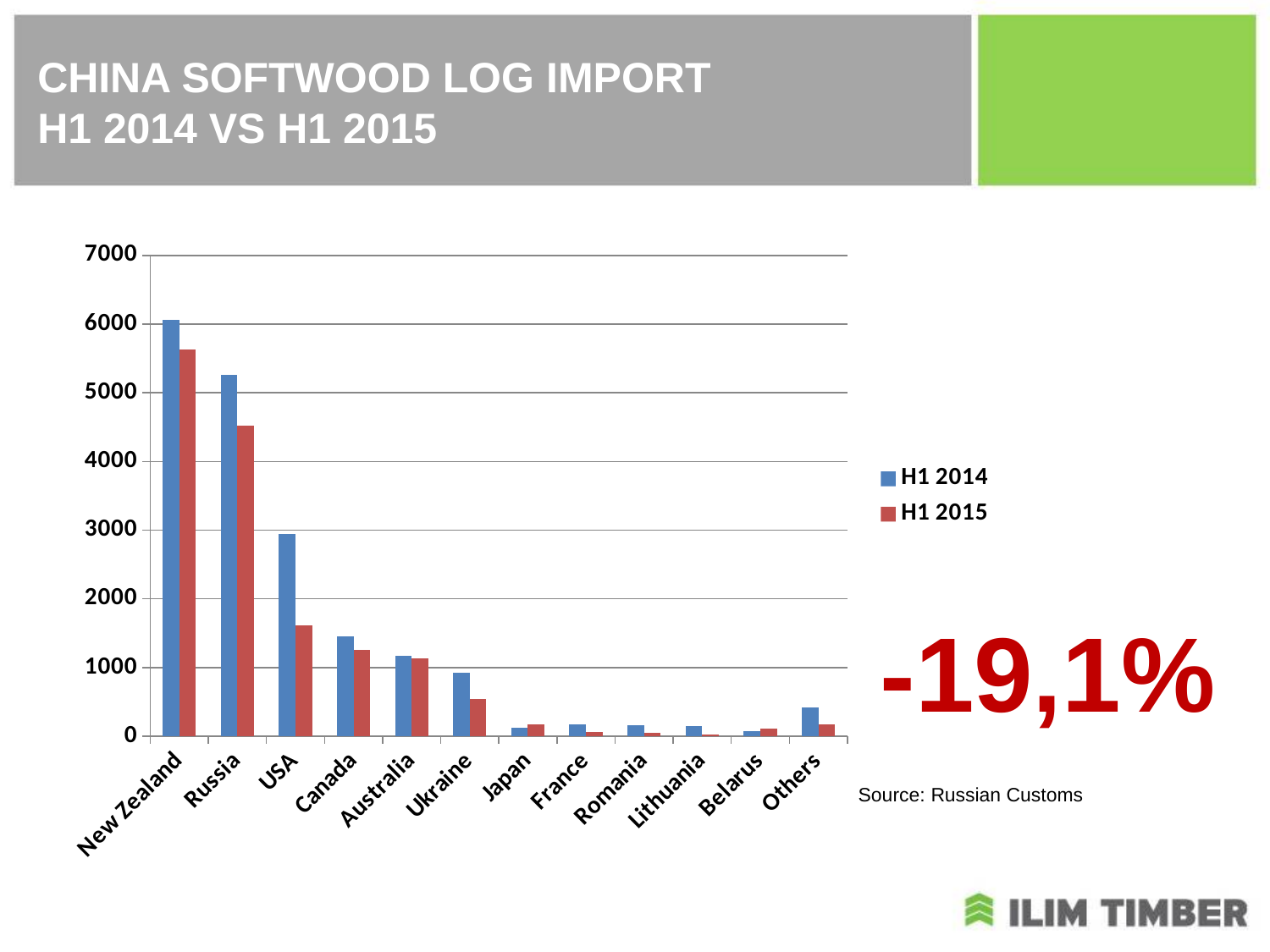
Is the H1 2015 value for Russia greater or less than 5000? less For USA, which is larger: the H1 2014 value or the H1 2015 value? H1 2014 Is the H1 2014 value for USA greater or less than 2000? greater What kind of chart is shown on the slide? bar chart How many series does the legend list? 2 Is the H1 2015 value for Ukraine greater or less than 1000? less What is the title of the slide containing the chart? CHINA SOFTWOOD LOG IMPORT H1 2014 VS H1 2015 Which category has the highest H1 2014 value? New Zealand Which category has the highest H1 2015 value? New Zealand How many countries/categories are shown on the x axis of the chart? 12 Which is larger: the H1 2014 value for Russia or the H1 2014 value for Canada? Russia